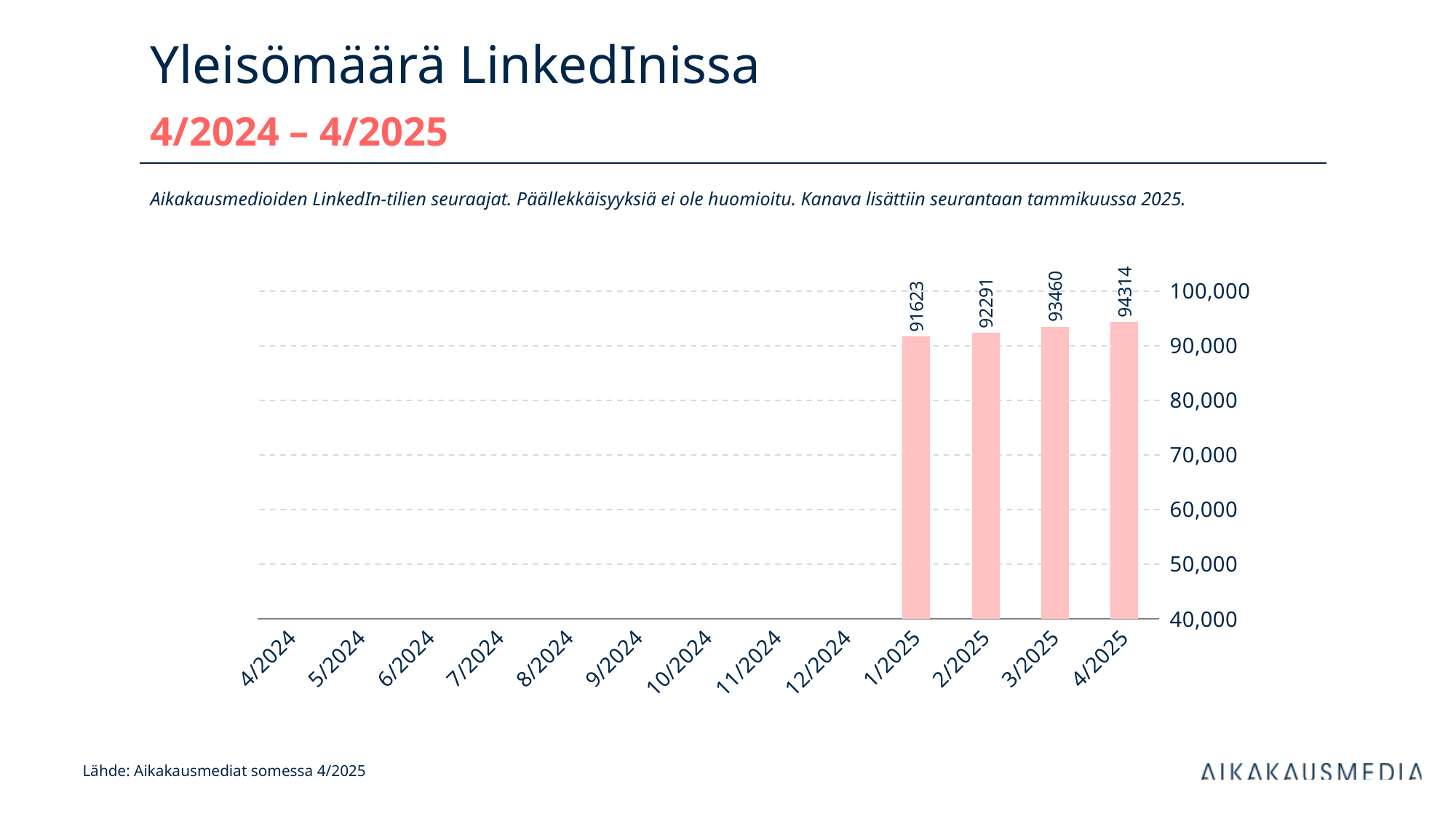
Among the months with bars, which has the lowest value? 1/2025 Is the value for 3/2025 greater or less than 90,000? greater Do the values rise or fall from 1/2025 to 4/2025? rise Which month has the highest value? 4/2025 Which is larger, the value for 2/2025 or 3/2025? 3/2025 What is the value for 1/2025? 91623 What is the value for 2/2025? 92291 What kind of chart is this? bar chart What is the value for 4/2025? 94314 What is the difference between the values for 4/2025 and 1/2025? 2691 How many months are shown on the x axis? 13 What is the value for 3/2025? 93460